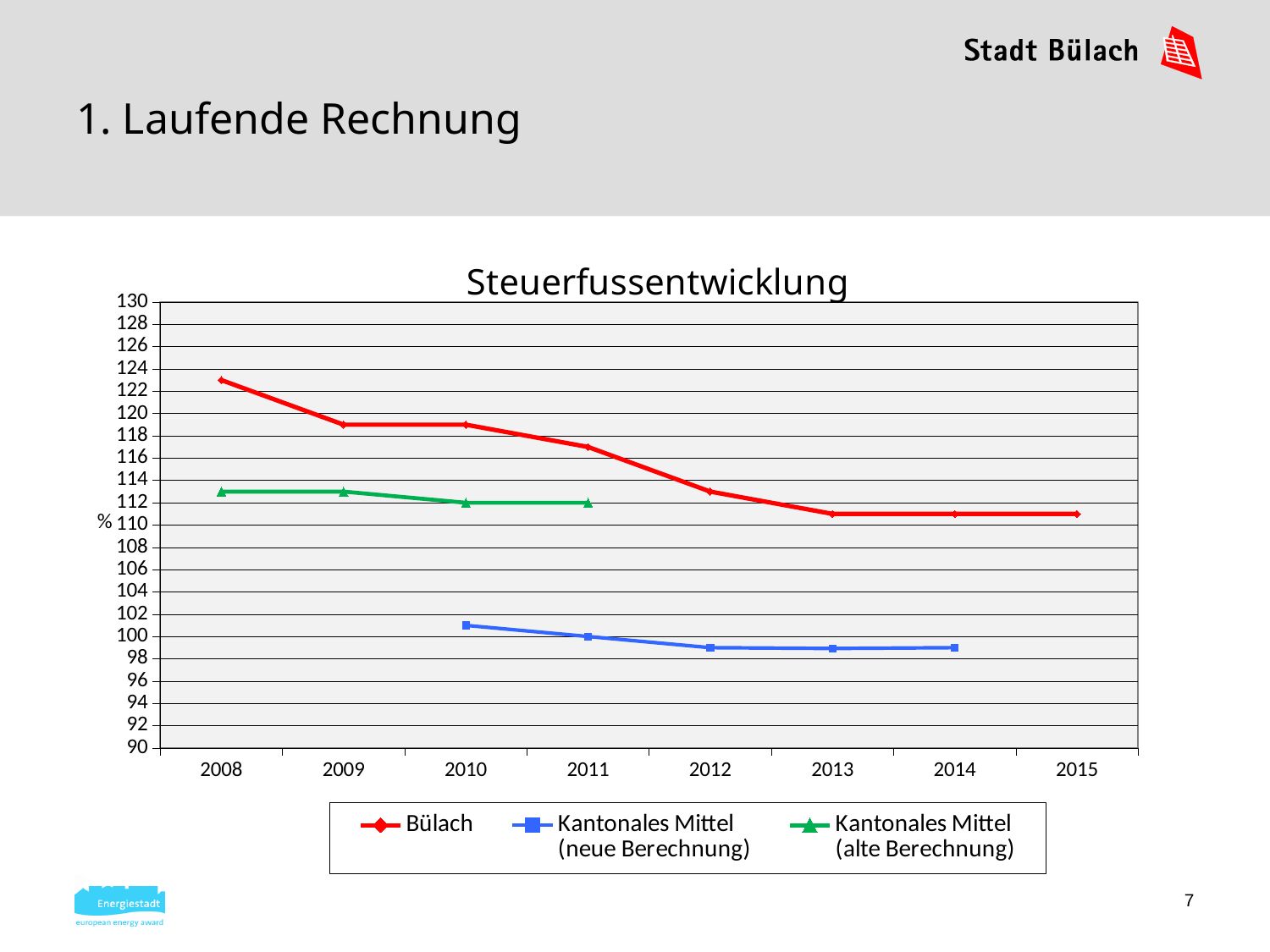
How many years are shown on the x axis? 8 What is the value for Kantonales Mittel (alte Berechnung) in 2011? 112 What is the title of the chart? Steuerfussentwicklung How many series does the legend list? 3 Is the value for Kantonales Mittel (neue Berechnung) in 2014 greater or less than 100? less Does the Bülach series rise or fall from 2008 to 2013? fall What type of chart is shown on the slide? line chart What is the value for Kantonales Mittel (neue Berechnung) in 2011? 100 Is the value for Bülach in 2008 greater or less than 120? greater Is the value for Bülach in 2013 greater or less than 112? less What is the value for Kantonales Mittel (alte Berechnung) in 2010? 112 Which series has the highest values across the chart? Bülach